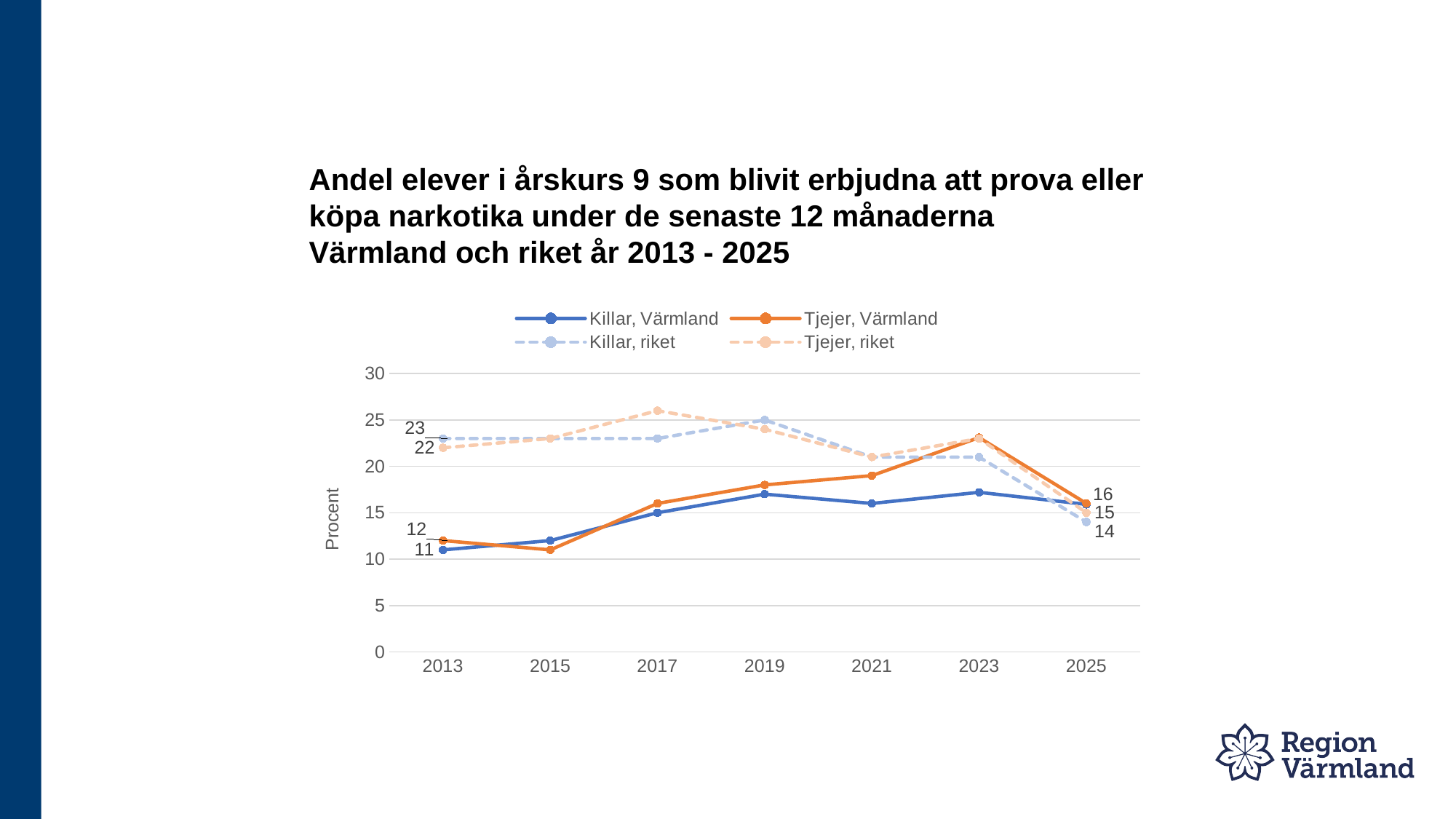
Is the value for Killar, Värmland in 2019 greater or less than 20? less What is the value for Tjejer, riket in 2025? 15 By how much did the value for Killar, riket fall from 2013 to 2025? 9 Does the Killar, riket line rise or fall from 2019 to 2025? fall What is the value for Killar, Värmland in 2013? 11 What kind of chart is shown on the slide? line chart How many years are shown on the x axis? 7 What is the label on the y axis? Procent How many series does the legend list? 4 What is the value for Tjejer, Värmland in 2013? 12 What is the value for Killar, riket in 2013? 23 What is the value for Killar, riket in 2025? 14